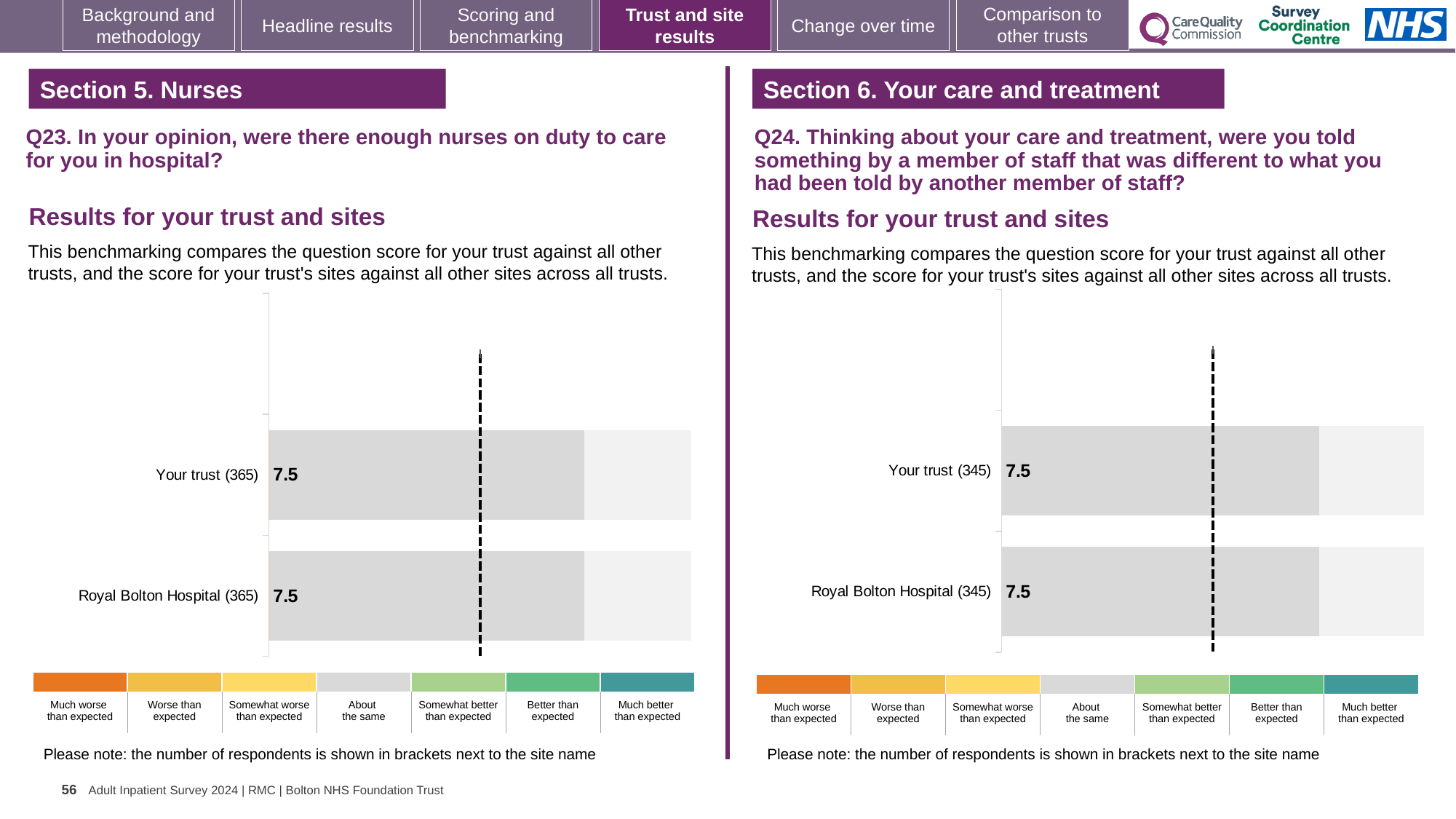
How many bars are plotted on the Q24 chart (right)? 2 On the Q24 chart (right), what is the difference between the score for Your trust and the score for Royal Bolton Hospital? 0.0 On the Q24 chart (right), is the score for Your trust greater or less than 5? greater How many bars are plotted on the Q23 chart (left)? 2 On the Q23 chart (left), what is the score for Royal Bolton Hospital? 7.5 What kind of chart is the Q23 chart (left)? Bar chart On the Q24 chart (right), how many respondents are shown in brackets next to Royal Bolton Hospital? 345 On the Q24 chart (right), what is the score for Your trust? 7.5 On the Q24 chart (right), what is the score for Royal Bolton Hospital? 7.5 On the Q23 chart (left), how many respondents are shown in brackets next to Your trust? 365 On the Q23 chart (left), what is the difference between the score for Your trust and the score for Royal Bolton Hospital? 0.0 On the Q23 chart (left), what is the score for Your trust? 7.5